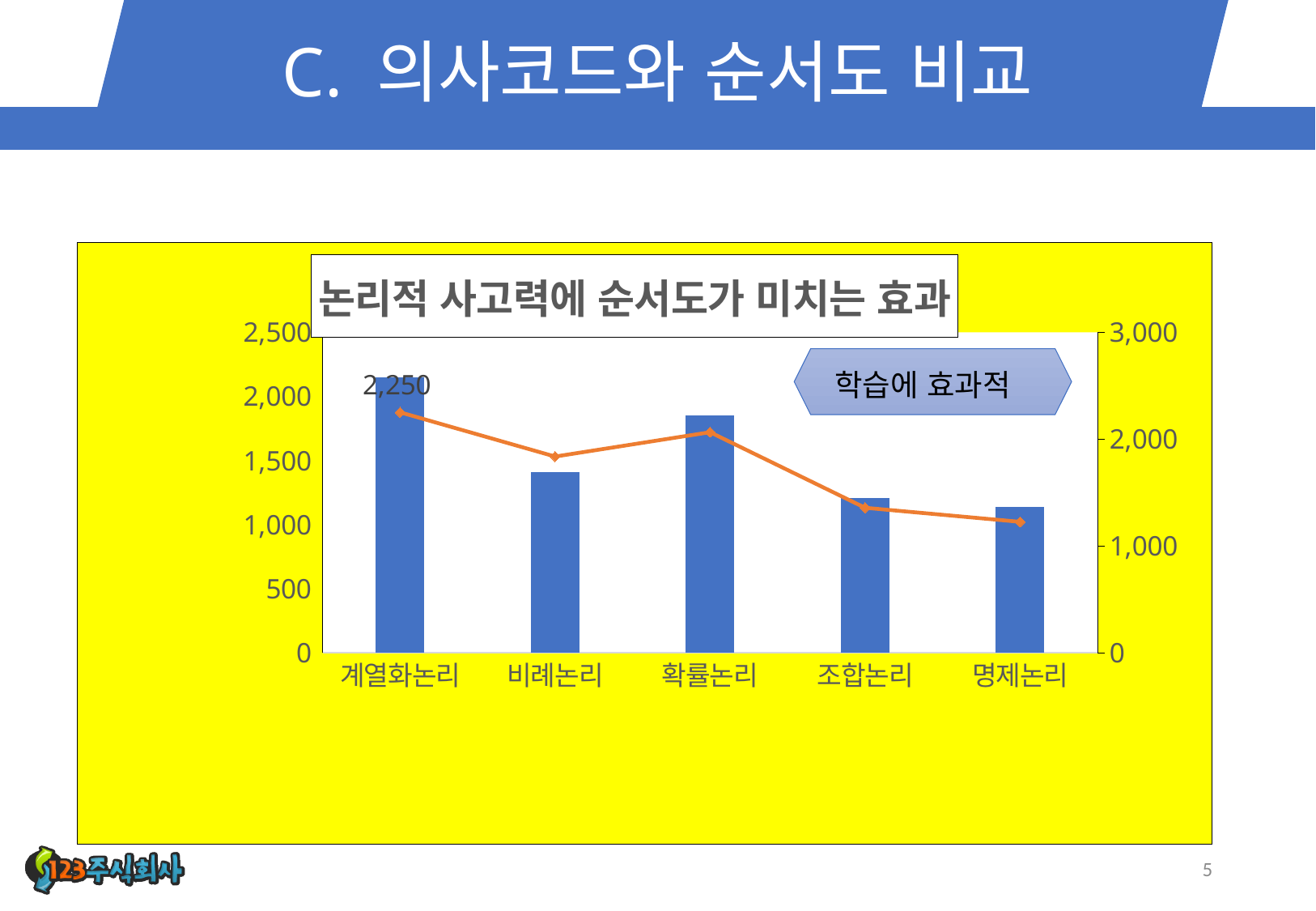
Is the bar value for 확률논리 greater or less than 1,500 on the left axis? greater What value is printed as the data label on the 계열화논리 bar? 2,250 Which category has the tallest bar? 계열화논리 Which has the taller bar, 계열화논리 or 조합논리? 계열화논리 How many categories are shown on the x axis? 5 Which has the taller bar, 확률논리 or 비례논리? 확률논리 What text is shown in the callout shape inside the chart? 학습에 효과적 What is the title of the chart? 논리적 사고력에 순서도가 미치는 효과 Is the bar value for 명제논리 greater or less than 1,000 on the left axis? greater What kind of chart is this? Bar chart with a line overlay Does the orange line rise or fall from 확률논리 to 조합논리? fall Is the bar value for 비례논리 greater or less than 1,500 on the left axis? less